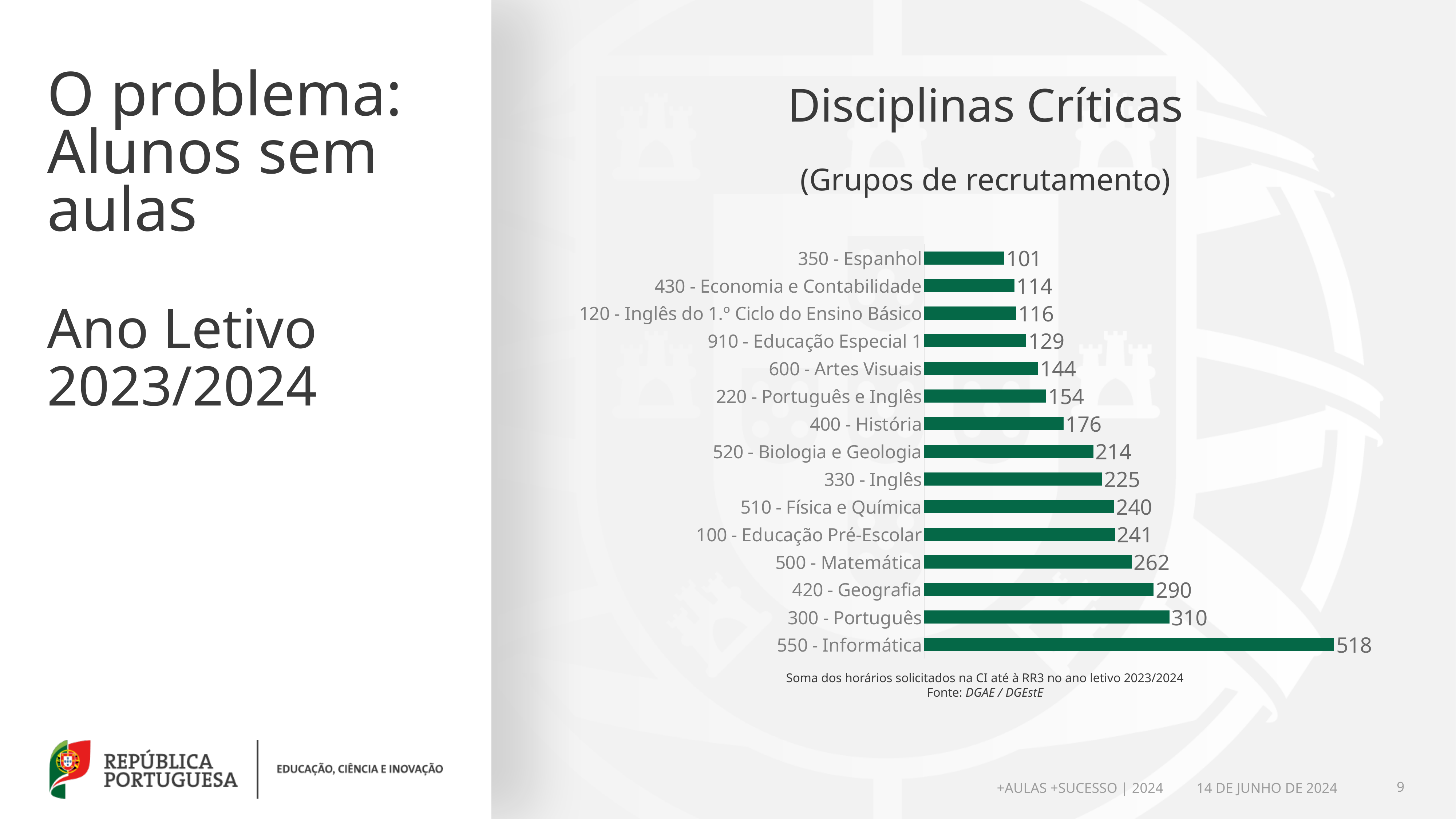
What is the value for 120 - Inglês do 1.º Ciclo do Ensino Básico? 116 What is the difference between the values for 300 - Português and 420 - Geografia? 20 What is the difference between the values for 550 - Informática and 350 - Espanhol? 417 What is the value for 550 - Informática? 518 How many categories are shown in the chart? 15 What is the value for 500 - Matemática? 262 Which category has the highest value? 550 - Informática What kind of chart is shown on the slide? Bar chart What is the title of the chart? Disciplinas Críticas (Grupos de recrutamento) Which is larger, the value for 330 - Inglês or the value for 400 - História? 330 - Inglês What colour are the bars in the chart? Dark green Which category has the lowest value? 350 - Espanhol